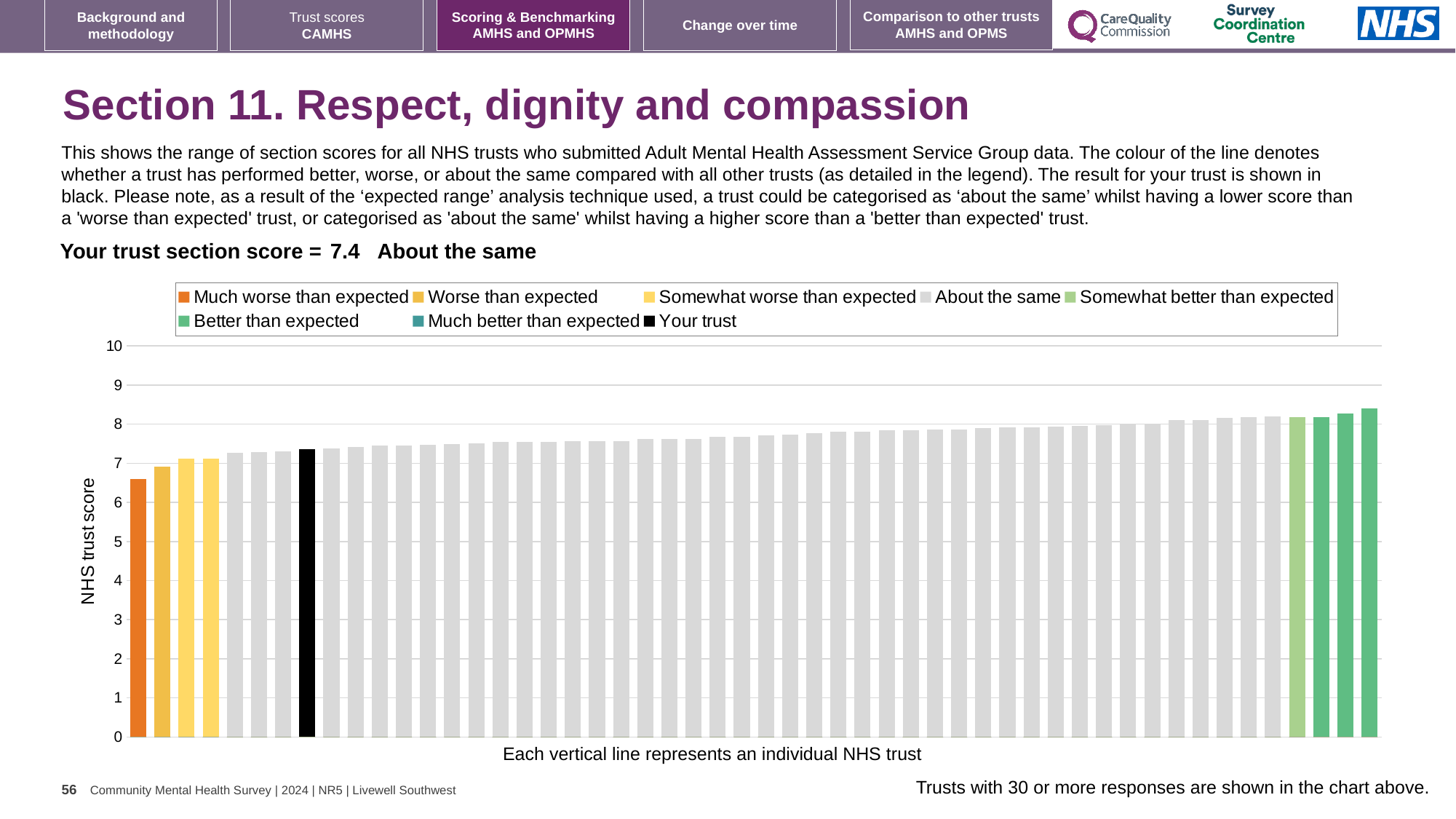
What is the title of the vertical axis? NHS trust score What is your trust's section score shown on the slide? 7.4 Is the value of the black 'Your trust' bar greater or less than 7? greater Which category is your trust's section score placed in? About the same Is the value of the tallest bar greater or less than 8? greater Which legend category does the tallest bar in the chart belong to? Better than expected How many entries does the chart legend list? 8 Which legend category does the shortest bar in the chart belong to? Much worse than expected Do the bar values rise or fall from left to right along the x axis? rise What kind of chart is shown on the slide? bar chart Is the value of the black 'Your trust' bar greater or less than 8? less